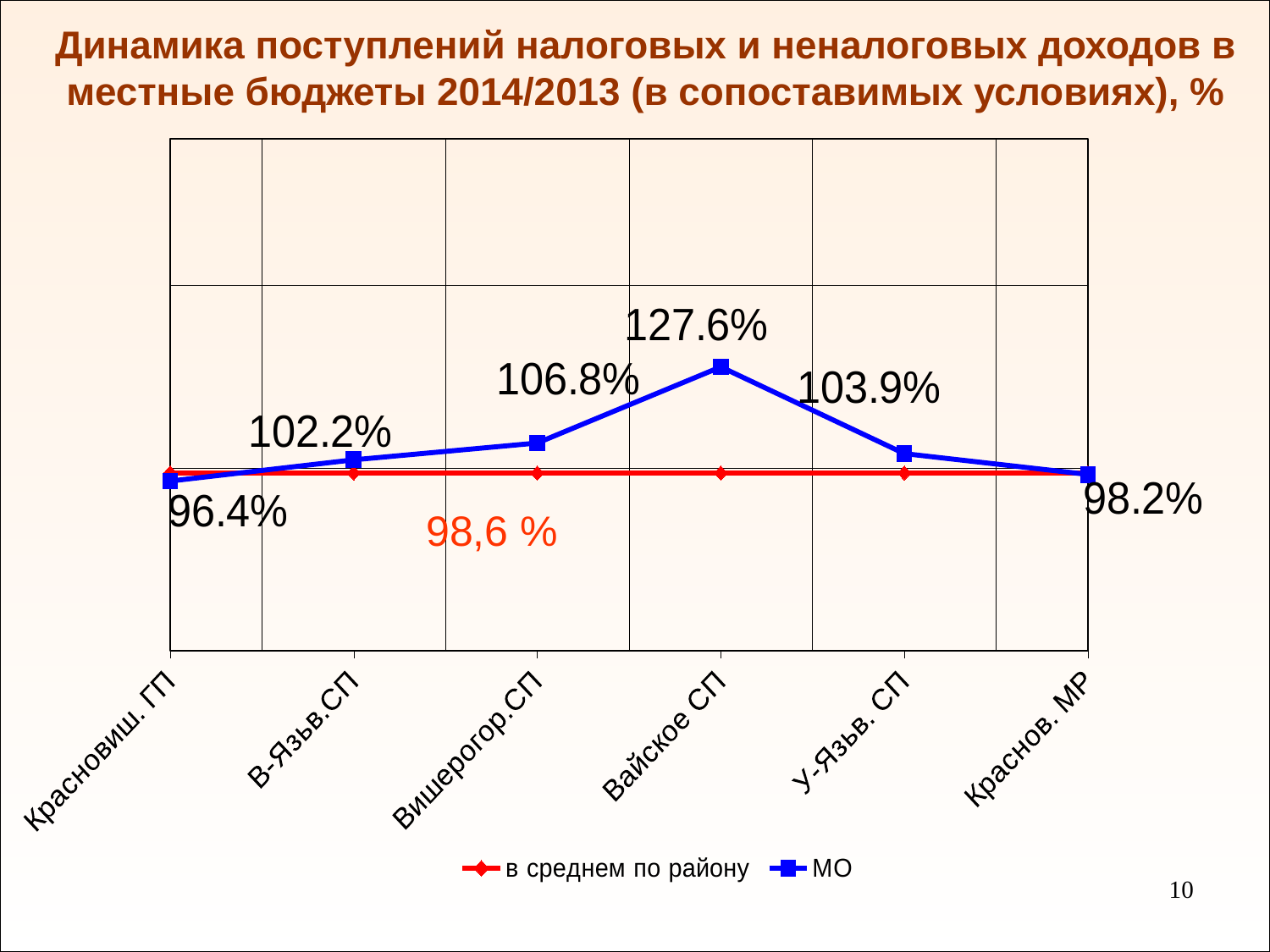
What is the difference between the МО values for Вайское СП and Вишерогор.СП? 20.8% How many categories are shown on the x axis? 6 Which category has the lowest МО value? Красновиш. ГП What is the МО value for У-Язьв. СП? 103.9% What kind of chart is shown on the slide? Line chart What is the МО value for Красновиш. ГП? 96.4% What is the МО value for Вайское СП? 127.6% Which category has the highest МО value? Вайское СП What is the МО value for Вишерогор.СП? 106.8% How many series does the legend list? 2 What value is shown for the series 'в среднем по району'? 98,6 % Which has the larger МО value, В-Язьв.СП or У-Язьв. СП? У-Язьв. СП